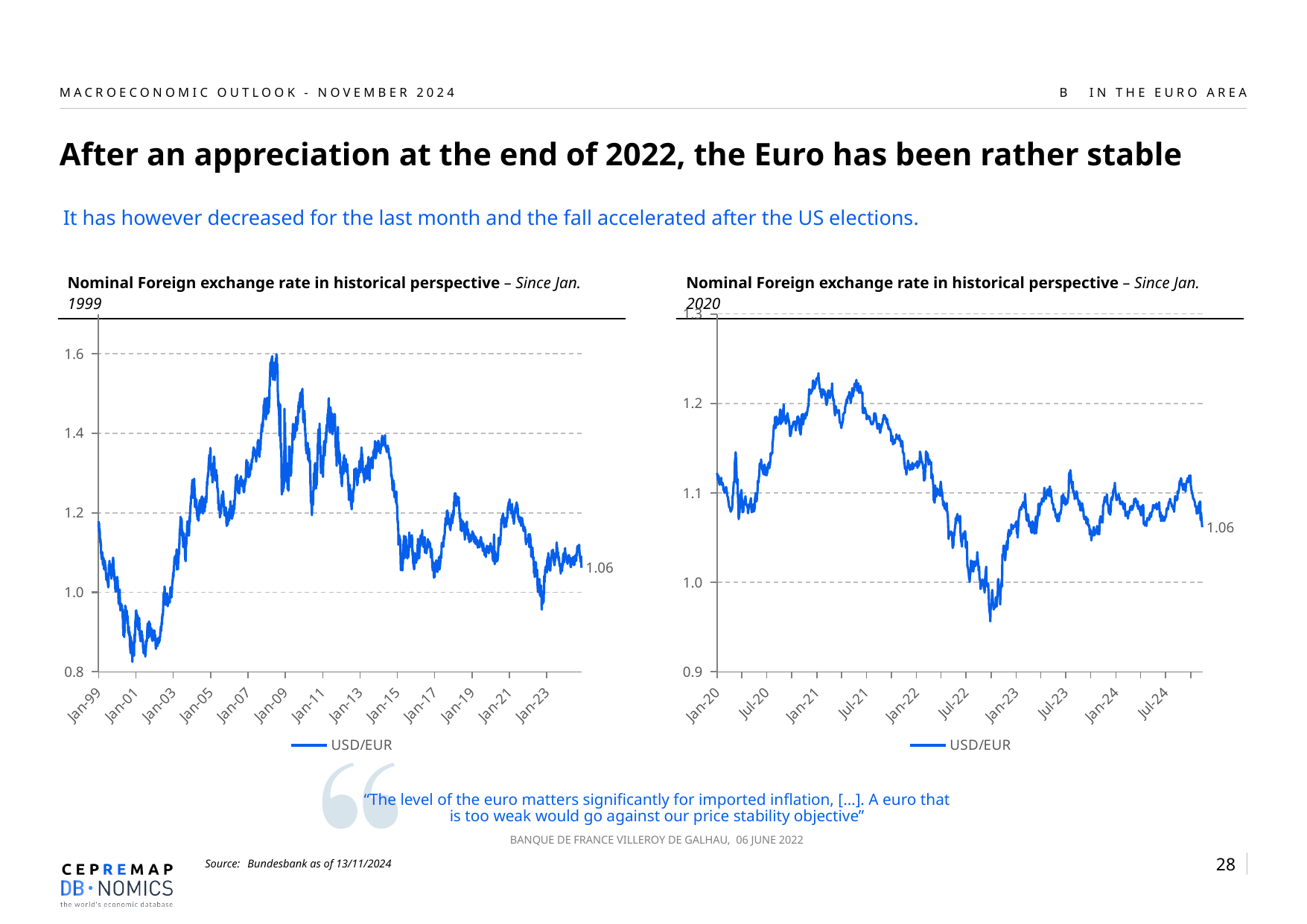
In the left chart (since Jan. 1999), is the peak value of USD/EUR around Jan-09 greater or less than 1.4? greater What is the name of the series shown in the legend of the right chart (since Jan. 2020)? USD/EUR How many series does the legend of the left chart (since Jan. 1999) list? 1 In the left chart (since Jan. 1999), around which x-axis label does USD/EUR reach its highest value? Jan-09 In the left chart (since Jan. 1999), is the USD/EUR value around Jan-01 greater or less than 1.0? less How many x-axis labels are shown on the right chart (since Jan. 2020)? 10 In the left chart (since Jan. 1999), what is the latest USD/EUR value labelled at the end of the line? 1.06 What kind of chart is the left chart, 'Nominal Foreign exchange rate in historical perspective – Since Jan. 1999'? Line chart In the right chart (since Jan. 2020), does the USD/EUR rate rise or fall between Jan-21 and Jan-23? Fall In the right chart (since Jan. 2020), is the USD/EUR value around Jan-21 greater or less than 1.2? greater In the right chart (since Jan. 2020), what is the latest USD/EUR value labelled at the end of the line? 1.06